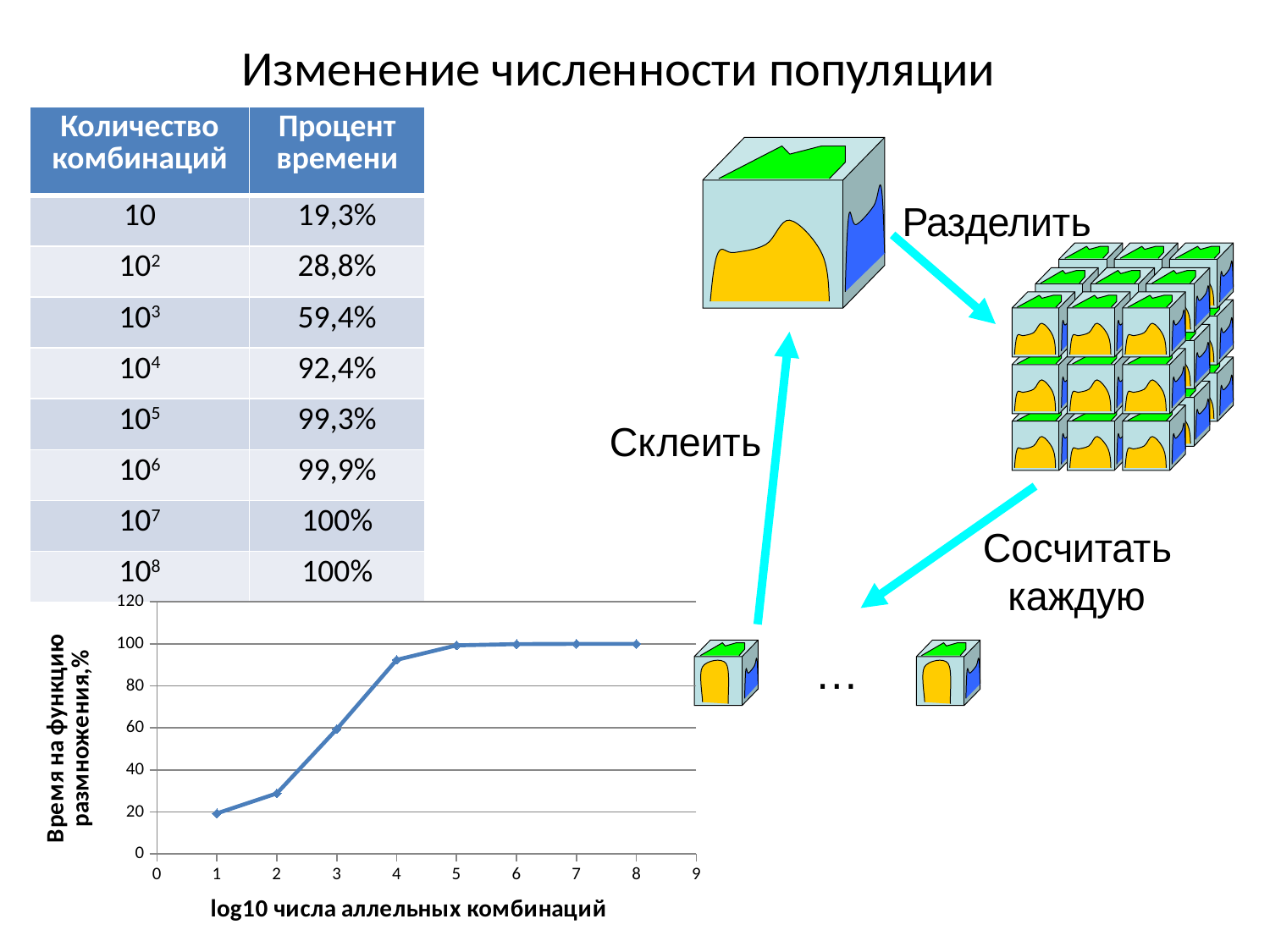
What kind of chart is shown at the bottom left of the slide? line chart How many data points are plotted on the line chart? 8 On the line chart, is the value at x = 3 greater or less than 40? greater Do the values on the line chart rise or fall as the x axis value increases? rise On the line chart, which x value has the lowest plotted value? 1 On the line chart, what is the plotted value at x = 7? 100 What is the title of the y axis of the line chart? Время на функцию размножения,% On the line chart, is the value at x = 1 greater or less than 40? less On the line chart, is the value at x = 4 greater or less than 80? greater What is the title of the x axis of the line chart? log10 числа аллельных комбинаций On the line chart, which is larger: the value at x = 3 or the value at x = 4? x = 4 On the line chart, what is the plotted value at x = 8? 100